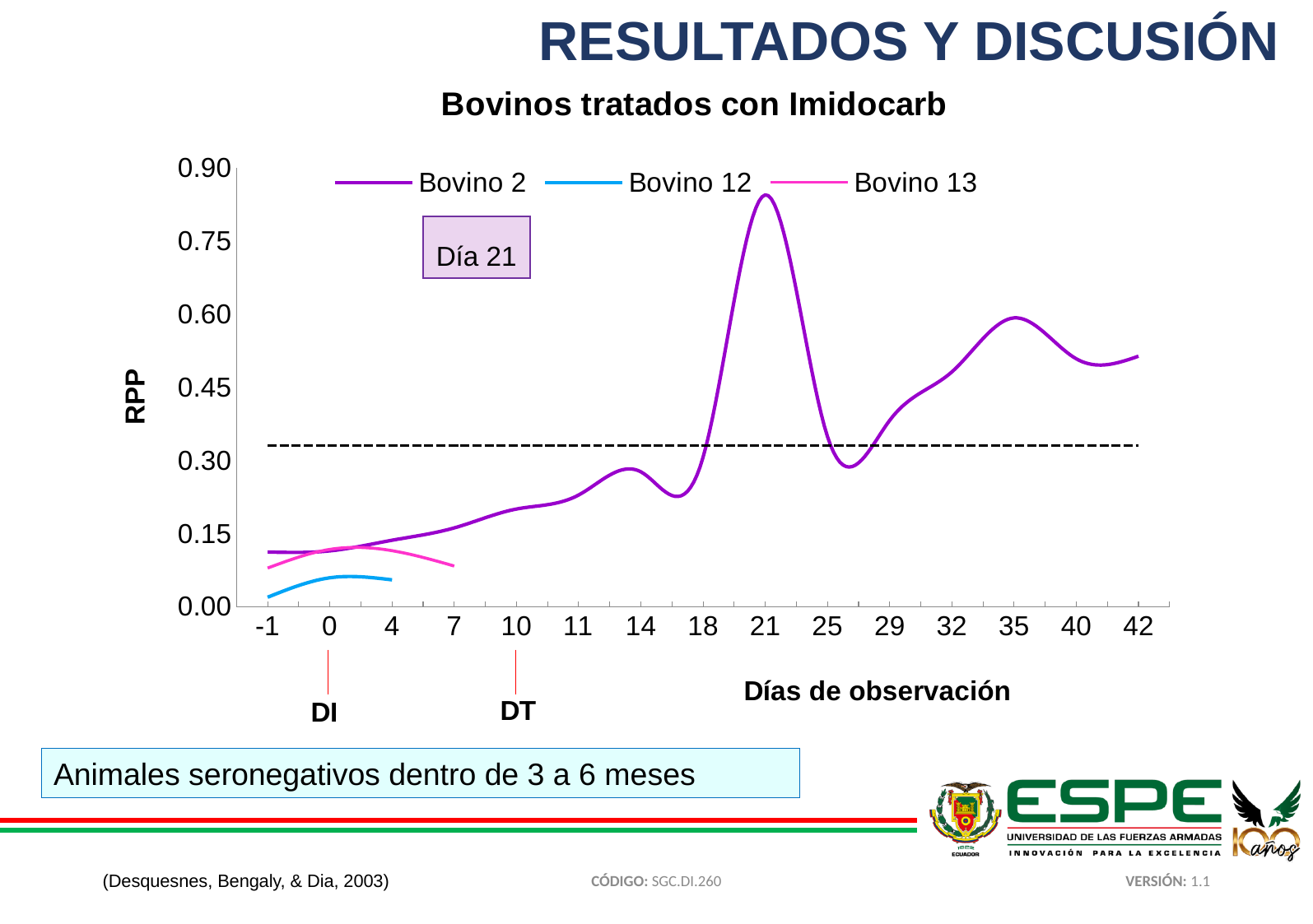
What is the title of the chart? Bovinos tratados con Imidocarb Is the value for Bovino 12 at day 0 greater or less than 0.15? less Does the Bovino 2 line rise or fall between day -1 and day 21? rise Which is larger for Bovino 2: the value at day 21 or the value at day 35? day 21 On which observation day does the Bovino 2 line reach its highest value? 21 How many day values are marked on the x axis? 15 How many series does the legend list? 3 What kind of chart is shown on the slide? line chart What is the label of the y axis? RPP Is the value for Bovino 2 at day 21 greater or less than 0.75? greater Is the value for Bovino 2 at day -1 greater or less than 0.15? less